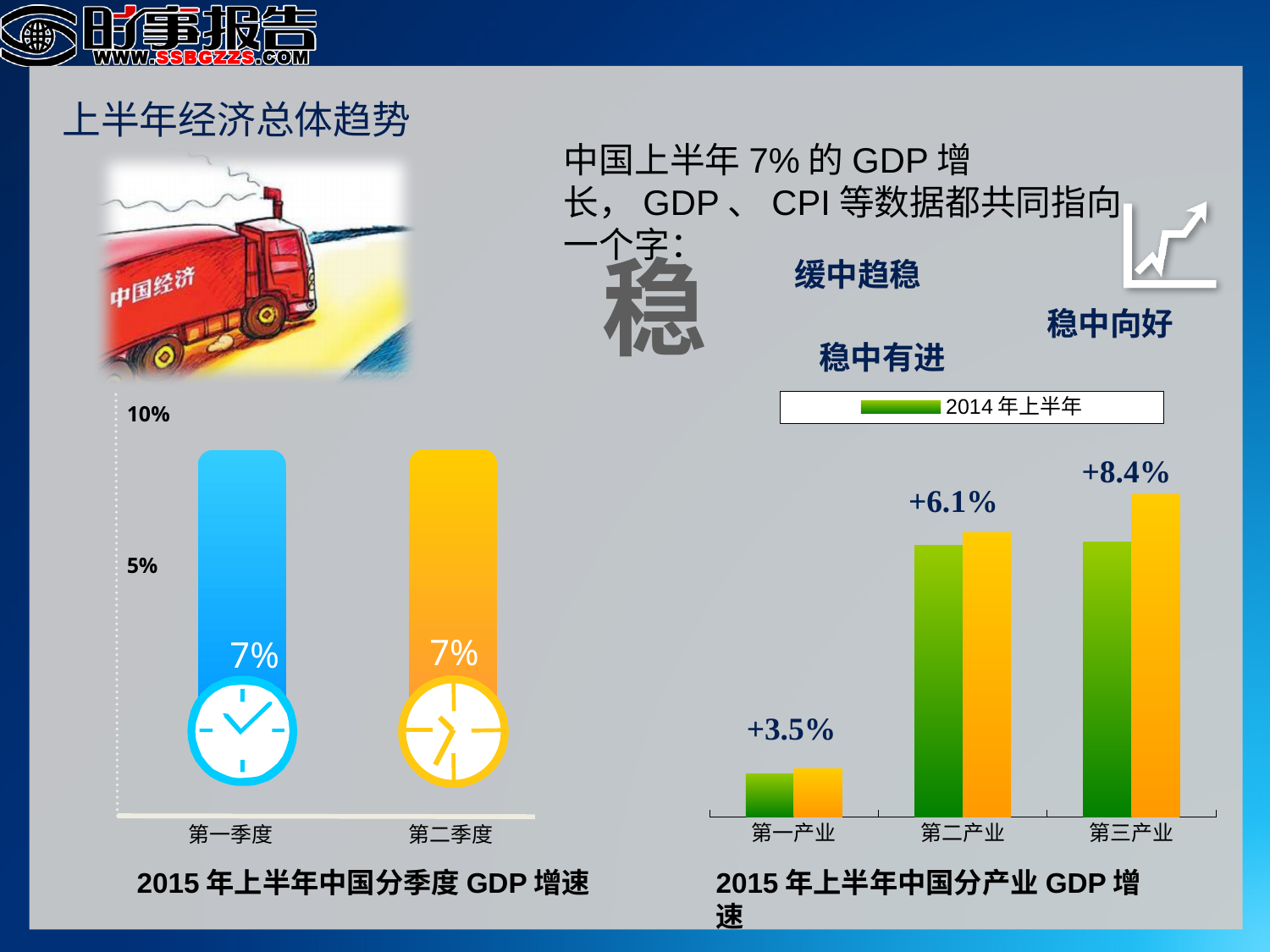
How many categories are shown in the left chart (2015年上半年中国分季度GDP增速)? 2 In the right chart (2015年上半年中国分产业GDP增速), what entry does the legend list? 2014年上半年 In the left chart (2015年上半年中国分季度GDP增速), what is the value for 第二季度? 7% What kind of chart is the left chart titled 2015年上半年中国分季度GDP增速? bar chart In the right chart (2015年上半年中国分产业GDP增速), what growth rate is labelled for 第三产业? +8.4% In the right chart (2015年上半年中国分产业GDP增速), what is the difference between the labelled growth rates of 第三产业 and 第二产业? 2.3 percentage points In the right chart (2015年上半年中国分产业GDP增速), do the labelled growth rates rise or fall from 第一产业 to 第三产业? rise In the right chart (2015年上半年中国分产业GDP增速), which industry has the lowest labelled growth rate? 第一产业 In the left chart (2015年上半年中国分季度GDP增速), what is the value for 第一季度? 7% In the right chart (2015年上半年中国分产业GDP增速), what growth rate is labelled for 第一产业? +3.5% In the right chart (2015年上半年中国分产业GDP增速), which industry has the highest labelled growth rate? 第三产业 In the left chart (2015年上半年中国分季度GDP增速), is the value for 第一季度 greater or less than 5%? greater